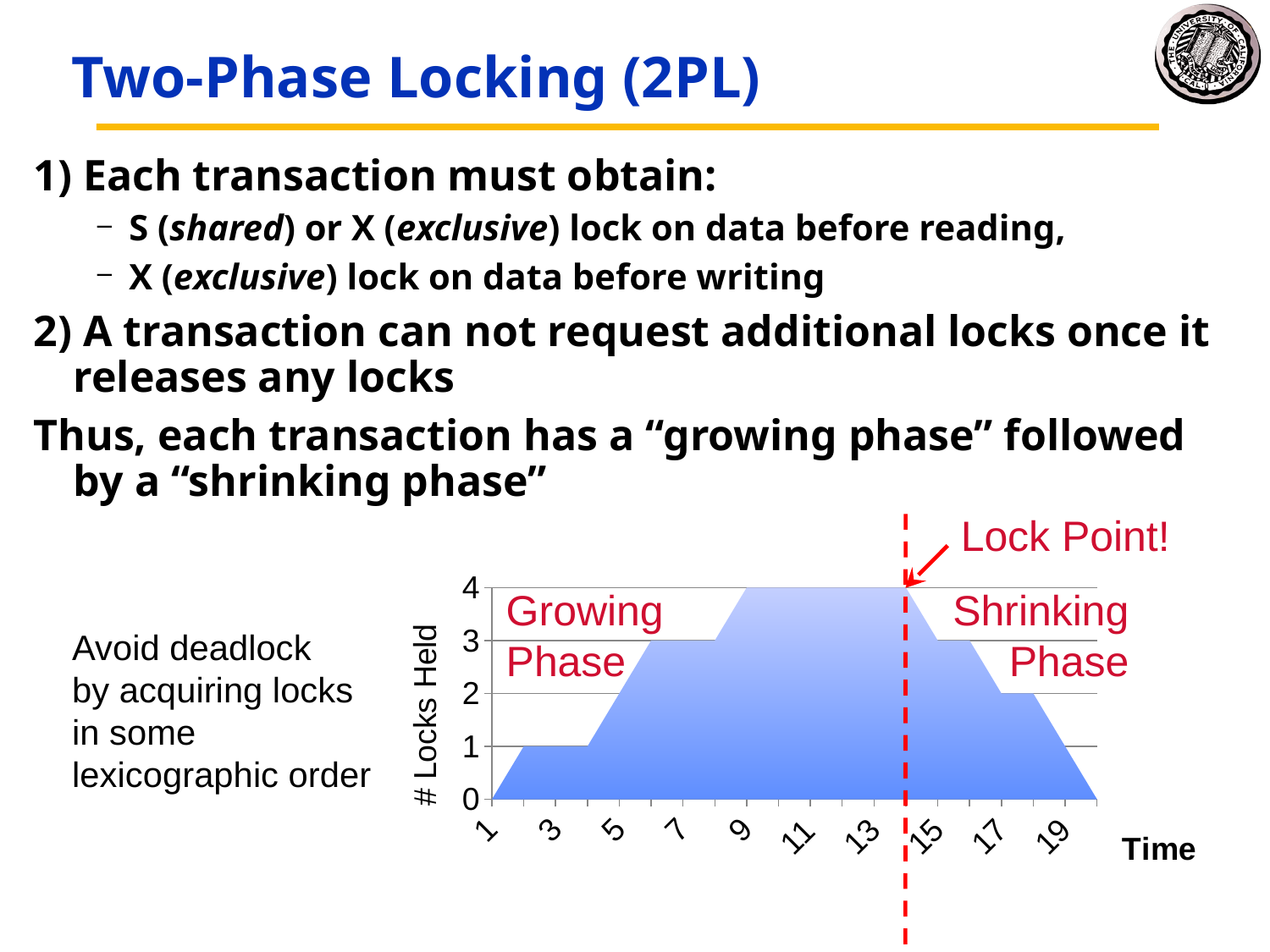
How many locks are held at time 3? 1 Is the number of locks held at time 3 greater or less than 2? less Is the number of locks held at time 11 greater or less than 3? greater How does the number of locks held change over time in the chart? rises, then falls What is the title of the vertical axis of the chart? # Locks Held What label is given to the horizontal axis of the chart? Time How many locks are held at time 11? 4 Is the number of locks held at time 17 greater or less than 3? less What kind of chart is shown on the slide? area chart What is the highest number of locks held shown in the chart? 4 Which time has more locks held, time 9 or time 3? time 9 How many locks are held at time 1? 0